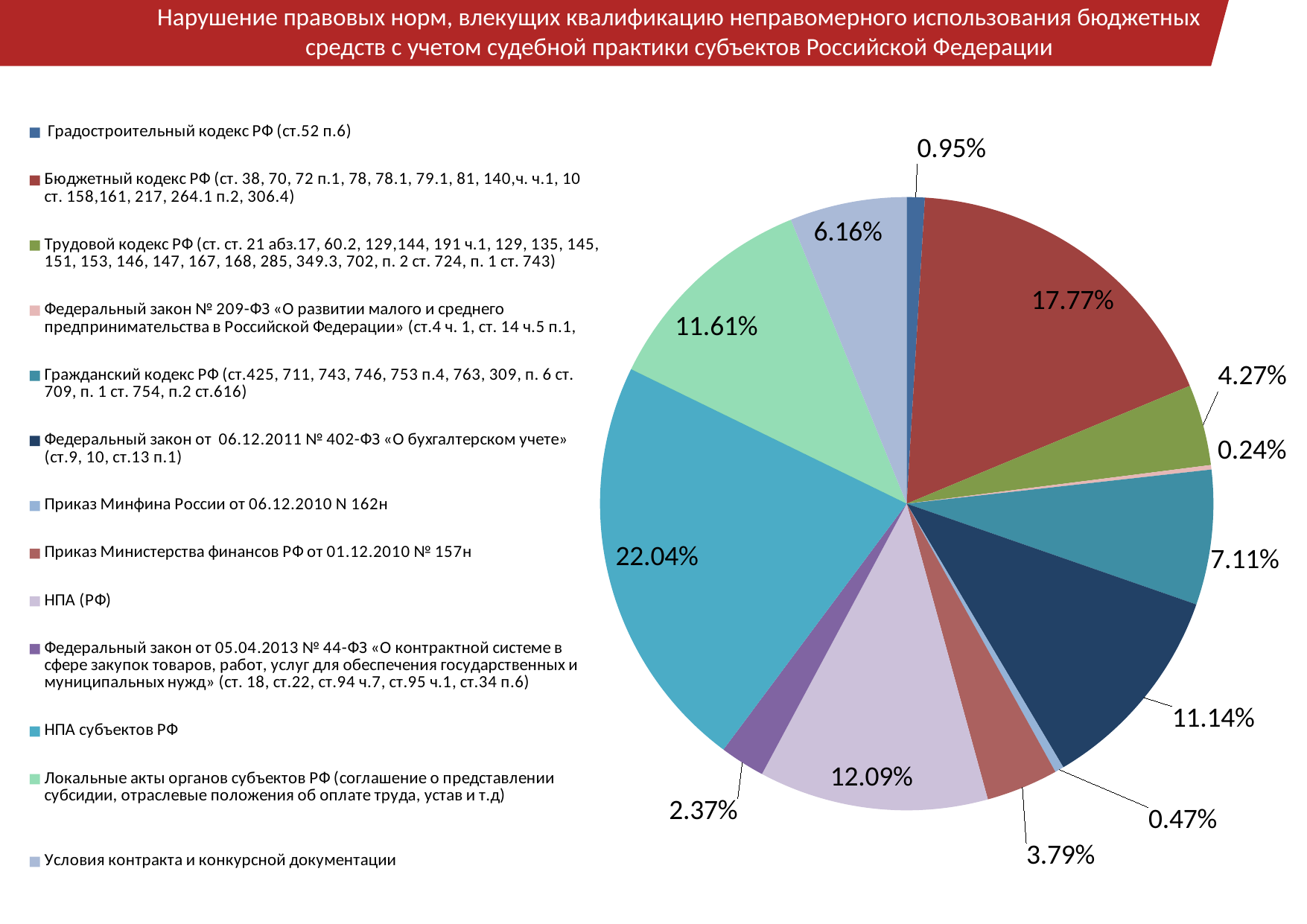
Which is larger: the share for НПА (РФ) or the share for Локальные акты органов субъектов РФ? НПА (РФ) What is the value shown for Приказ Минфина России от 06.12.2010 N 162н? 0.47% Which category has the smallest slice of the pie? Федеральный закон № 209-ФЗ «О развитии малого и среднего предпринимательства в Российской Федерации» What percentage is shown for Гражданский кодекс РФ? 7.11% What is the value for Условия контракта и конкурсной документации? 6.16% What share of the pie does НПА субъектов РФ account for? 22.04% What is the value shown for Бюджетный кодекс РФ? 17.77% What kind of chart is shown on the slide? pie chart What is the difference between the shares of НПА субъектов РФ and Бюджетный кодекс РФ? 4.27% How many slices does the pie chart have? 13 What is the combined share of Трудовой кодекс РФ and Федеральный закон от 05.04.2013 № 44-ФЗ? 6.64% Which category has the largest slice of the pie? НПА субъектов РФ